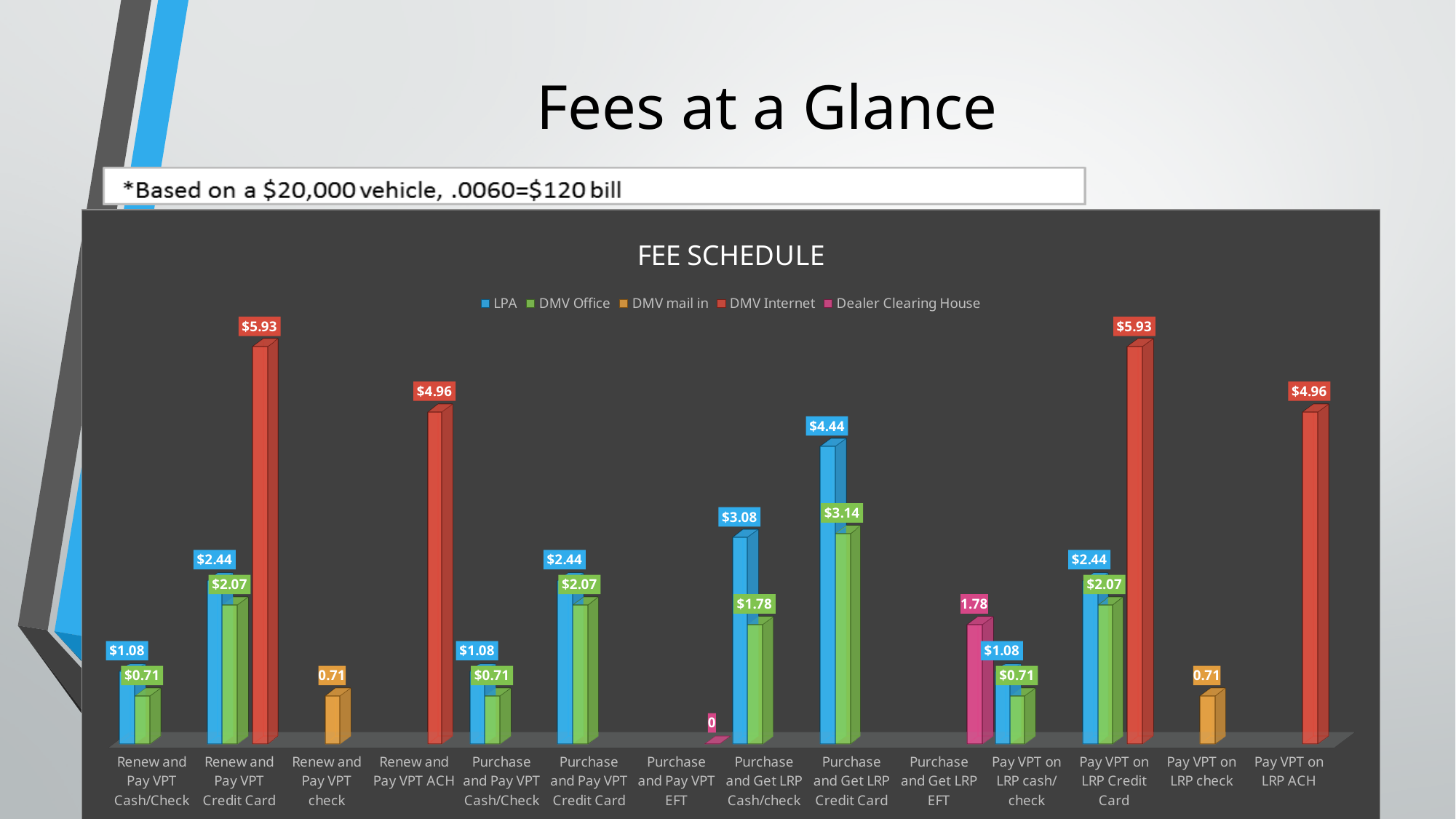
What is the DMV Office fee for Purchase and Get LRP Cash/check? $1.78 What is the DMV mail in fee for Pay VPT on LRP check? 0.71 What is the difference between the LPA fee and the DMV Office fee for Purchase and Get LRP Credit Card? $1.30 What is the DMV Internet fee for Renew and Pay VPT Credit Card? $5.93 What kind of chart is shown on the slide? Bar chart What is the Dealer Clearing House fee for Purchase and Get LRP EFT? 1.78 How many series does the legend list? 5 Which is larger, the DMV Internet fee for Renew and Pay VPT ACH or the DMV Internet fee for Renew and Pay VPT Credit Card? Renew and Pay VPT Credit Card Which category has the highest LPA fee? Purchase and Get LRP Credit Card How many categories are shown on the x axis? 14 What is the title of the chart? FEE SCHEDULE What is the LPA fee for Purchase and Get LRP Credit Card? $4.44